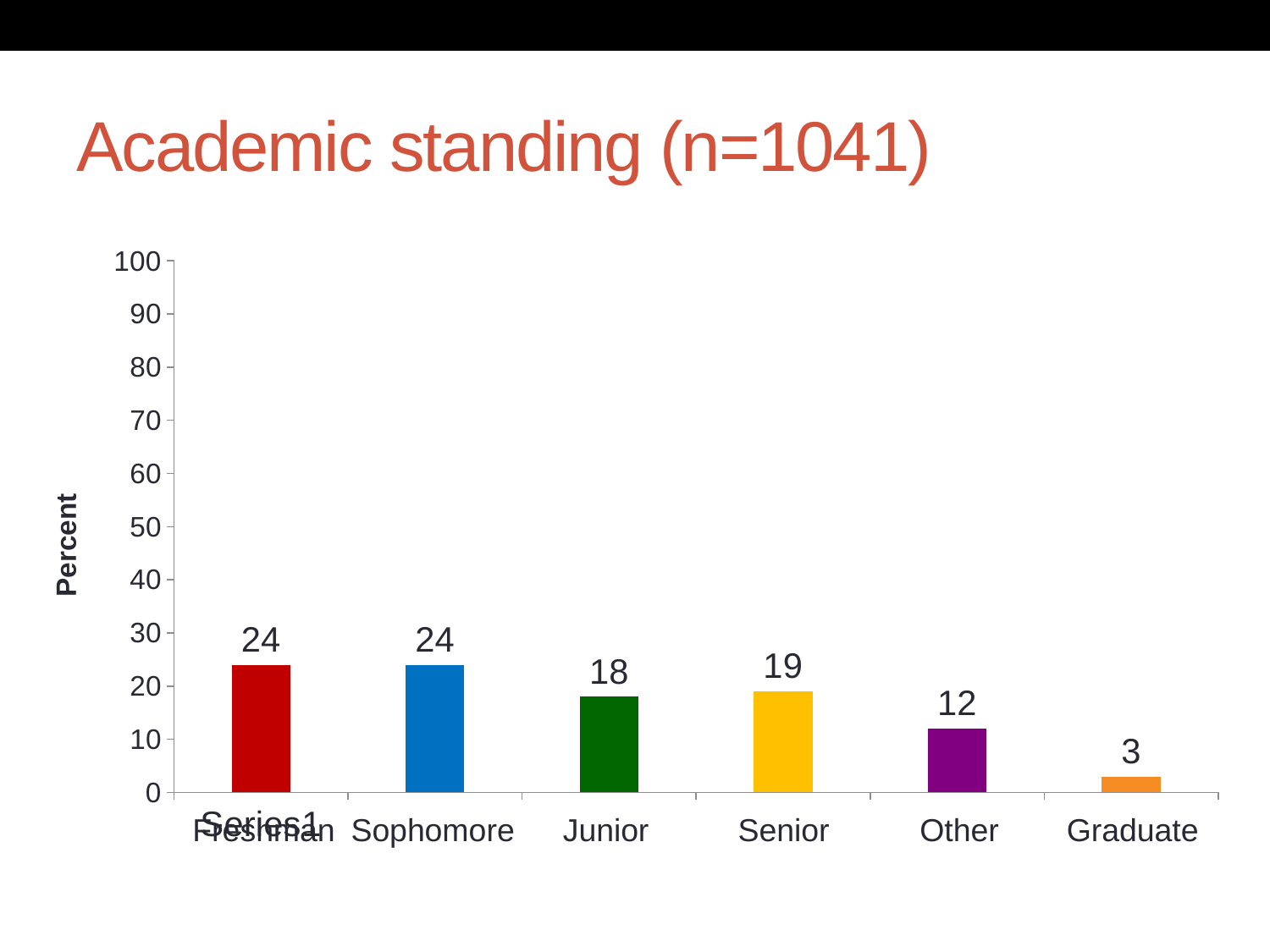
What is the difference between the values for Other and Graduate? 9 What is the label on the vertical axis? Percent What is the value for Graduate? 3 What is the value for Other? 12 How many categories are shown on the x axis? 6 Which is larger, the value for Senior or the value for Other? Senior What is the value for Senior? 19 What is the value for Junior? 18 Which category has the lowest value? Graduate What is the difference between the values for Sophomore and Junior? 6 What kind of chart is shown on the slide? Bar chart What is the value for Sophomore? 24